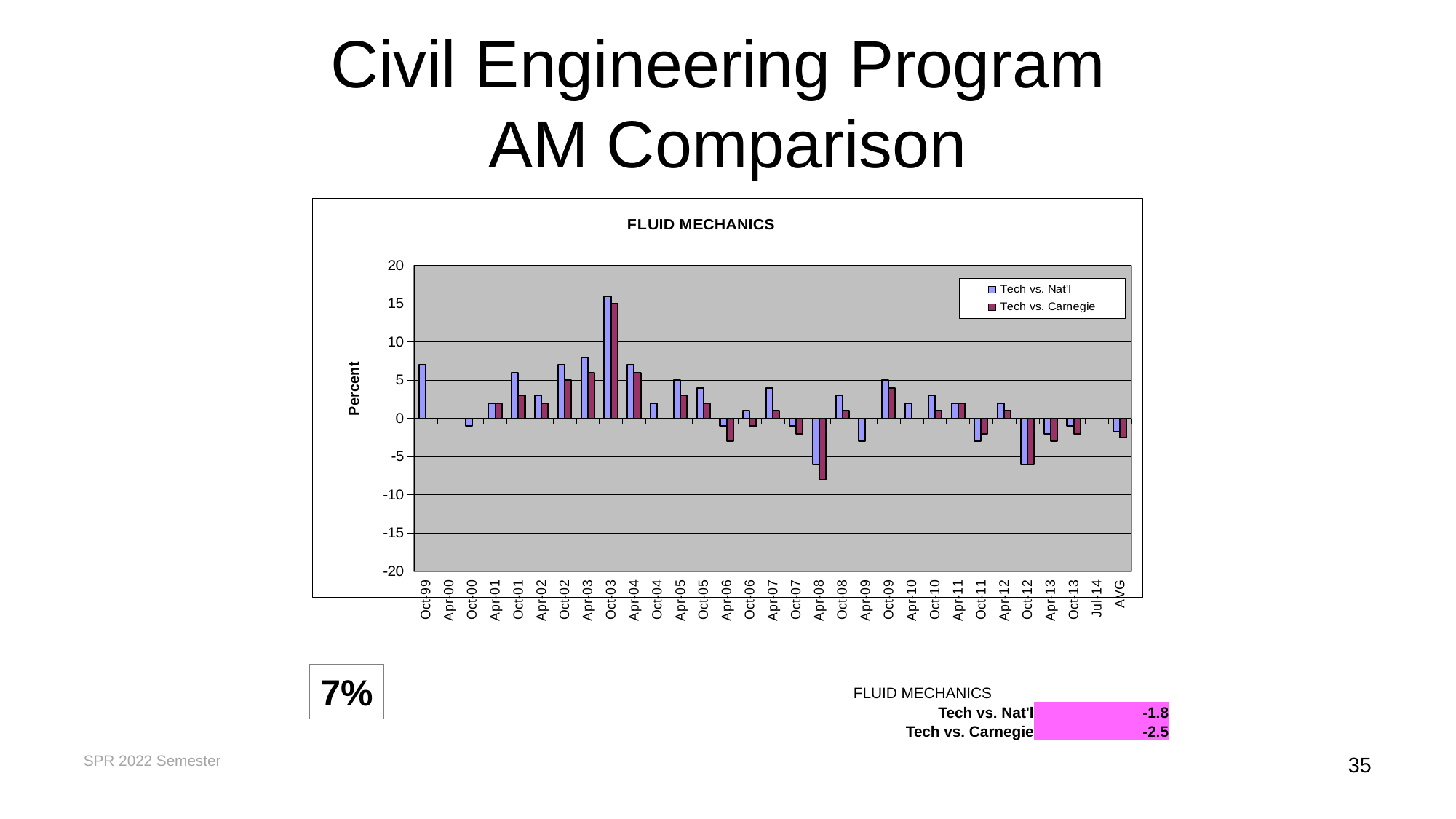
Is the Tech vs. Nat'l value for Oct-03 greater or less than 10? greater What is the title of the chart? FLUID MECHANICS Is the Tech vs. Nat'l value for Oct-99 greater or less than 5? greater How many series does the chart legend list? 2 Which is larger, the Tech vs. Nat'l value for Oct-03 or for Oct-99? Oct-03 Which category has the lowest Tech vs. Carnegie value? Apr-08 What kind of chart is shown on the slide? bar chart Which category has the highest Tech vs. Nat'l value? Oct-03 How many categories are shown along the x axis of the chart? 31 Is the Tech vs. Carnegie value for Apr-08 greater or less than -5? less What is the label on the vertical axis of the chart? Percent For Apr-03, which series has the larger value, Tech vs. Nat'l or Tech vs. Carnegie? Tech vs. Nat'l